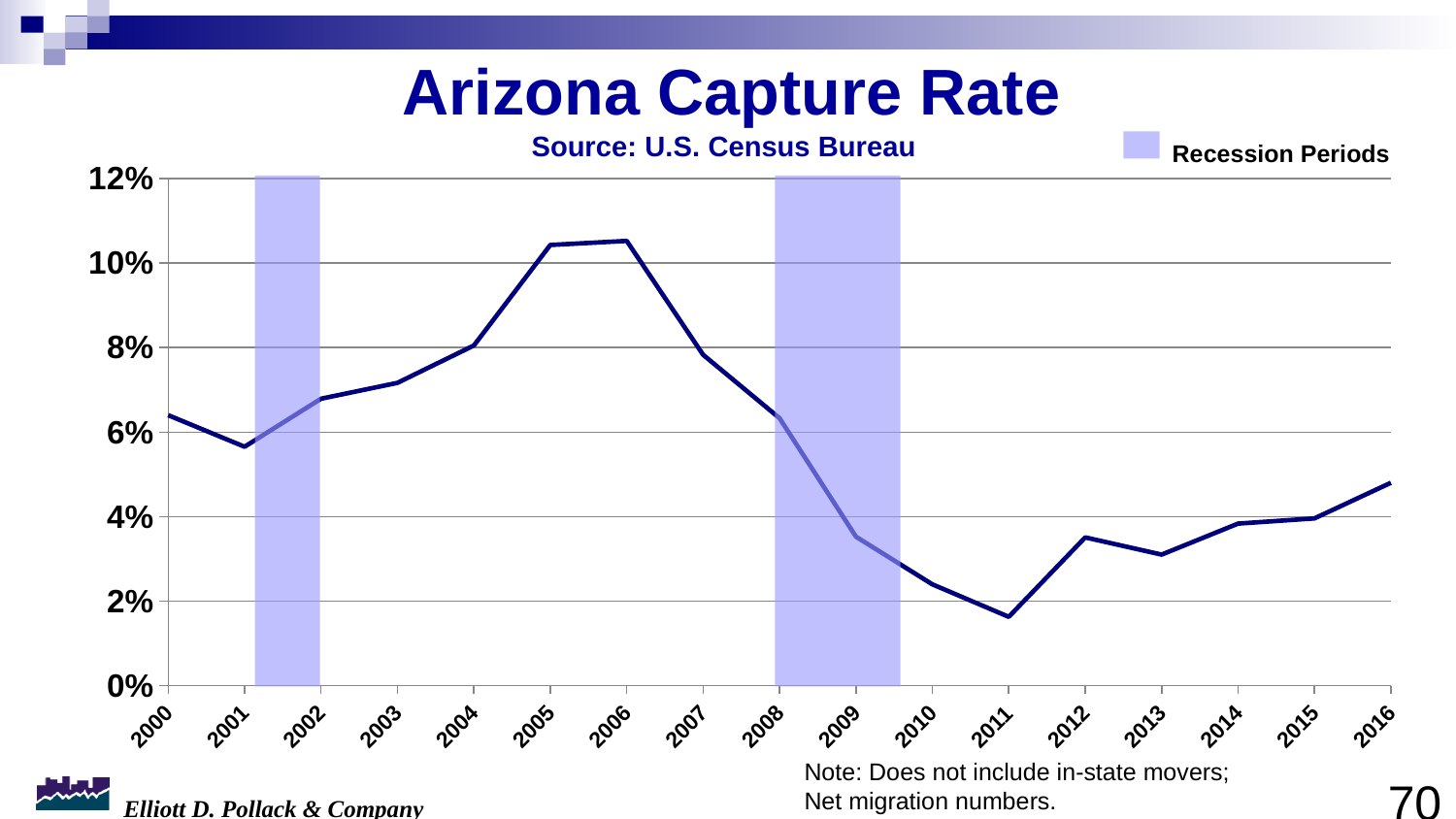
Is the value for 2011 greater or less than 2%? less What do the shaded vertical bands on the chart represent, according to the legend? Recession Periods Does the capture rate rise or fall from 2011 to 2016? rise Is the value for 2003 greater or less than 6%? greater Does the capture rate rise or fall from 2006 to 2011? fall Which year has the lowest Arizona capture rate? 2011 What kind of chart is shown on the slide? line chart Is the value for 2009 greater or less than 4%? less Which year has the larger capture rate, 2004 or 2012? 2004 How many years are plotted along the x axis? 17